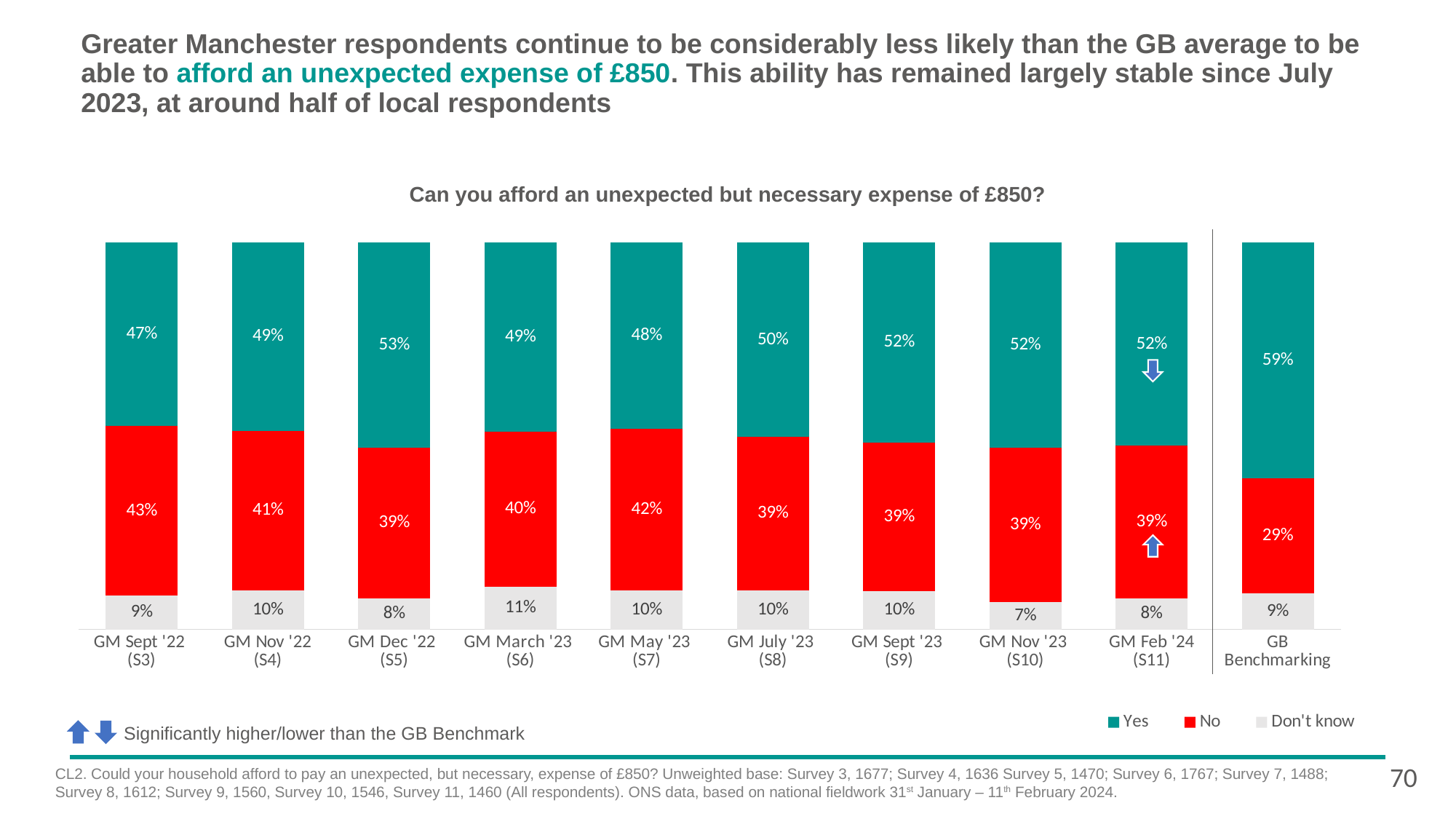
What is the difference between the Yes value for GB Benchmarking and the Yes value for GM Feb '24 (S11)? 7 percentage points How many categories are shown on the x axis? 10 What is the No value for GB Benchmarking? 29% How many series does the legend list? 3 Which category has the highest Yes value? GB Benchmarking What is the Don't know value for GM March '23 (S6)? 11% Which category has the highest No value? GM Sept '22 (S3) Which category has the lowest Don't know value? GM Nov '23 (S10) What percentage of GM Feb '24 (S11) respondents answered Yes? 52% What is the title of the chart? Can you afford an unexpected but necessary expense of £850? Which is larger: the No value for GM May '23 (S7) or the No value for GM July '23 (S8)? GM May '23 (S7) What kind of chart is shown on the slide? Stacked bar chart